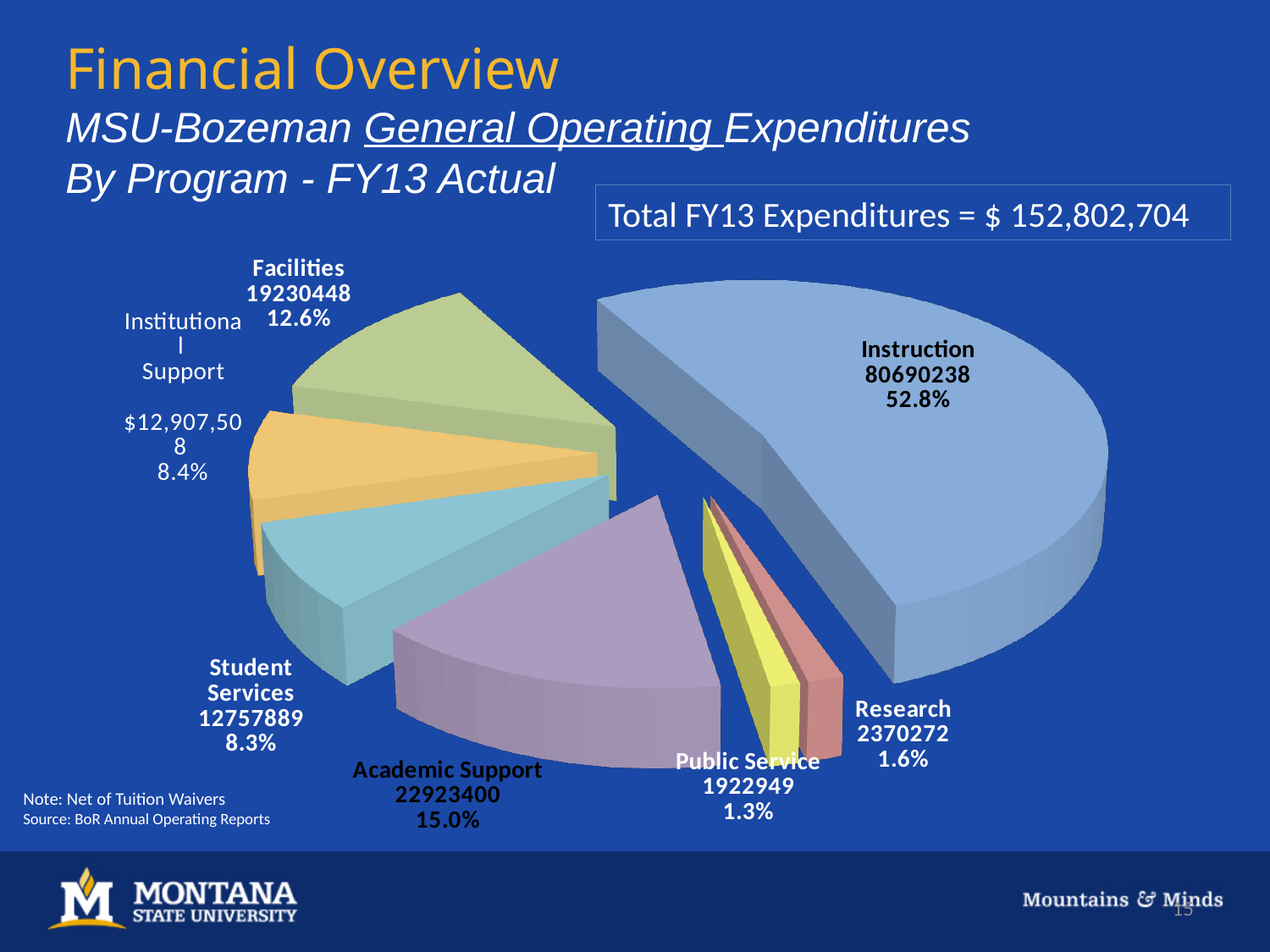
What is the difference between the Instruction and Academic Support expenditure values? 57766838 Which is larger, the expenditure for Facilities or for Academic Support? Academic Support How many program categories are shown in the pie chart? 7 Which program has the largest share of expenditures? Instruction What is the expenditure value for Facilities? 19230448 Which program has the smallest share of expenditures? Public Service What percentage share does Academic Support have? 15.0% What total FY13 expenditure figure is stated on the slide? $ 152,802,704 What is the expenditure value for Instruction? 80690238 What is the difference between the Research and Public Service expenditure values? 447323 What percentage share does Public Service have? 1.3% What kind of chart is shown on the slide? Pie chart